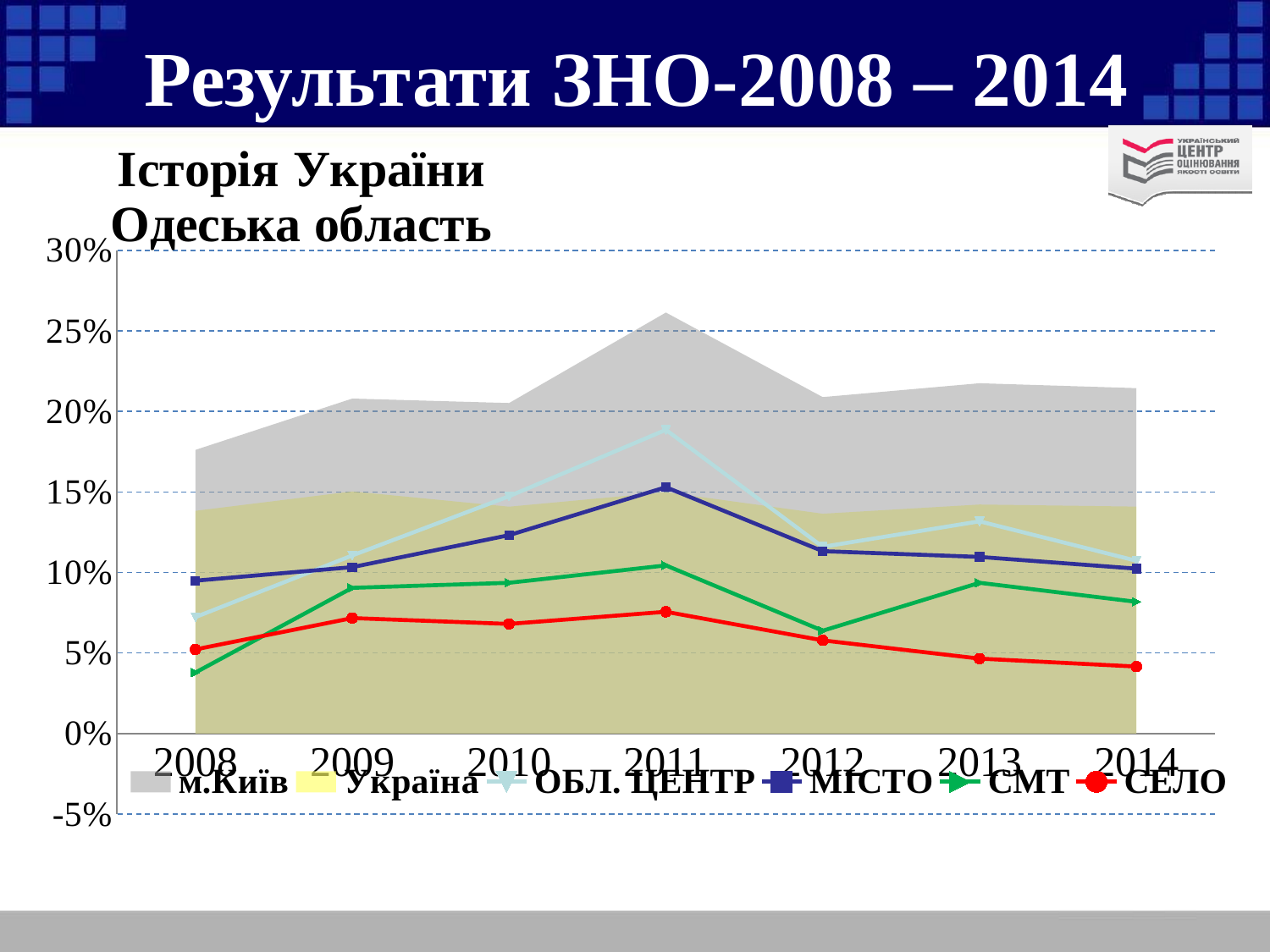
In which year does the ОБЛ. ЦЕНТР line reach its highest value? 2011 Which series is drawn in red on the chart? СЕЛО Is the value for м.Київ in 2011 greater or less than 25%? greater In which year does the м.Київ series reach its highest value? 2011 In which year is the СЕЛО line at its lowest value? 2014 Is the value for ОБЛ. ЦЕНТР in 2010 greater or less than 10%? greater How many years are shown along the x axis of the chart? 7 Is the value for СЕЛО in 2014 greater or less than 5%? less How many series does the chart legend list? 6 Does the СЕЛО line rise or fall from 2011 to 2014? falls Which series has the lowest value in 2008? СМТ In 2008, which is larger: МІСТО or ОБЛ. ЦЕНТР? МІСТО